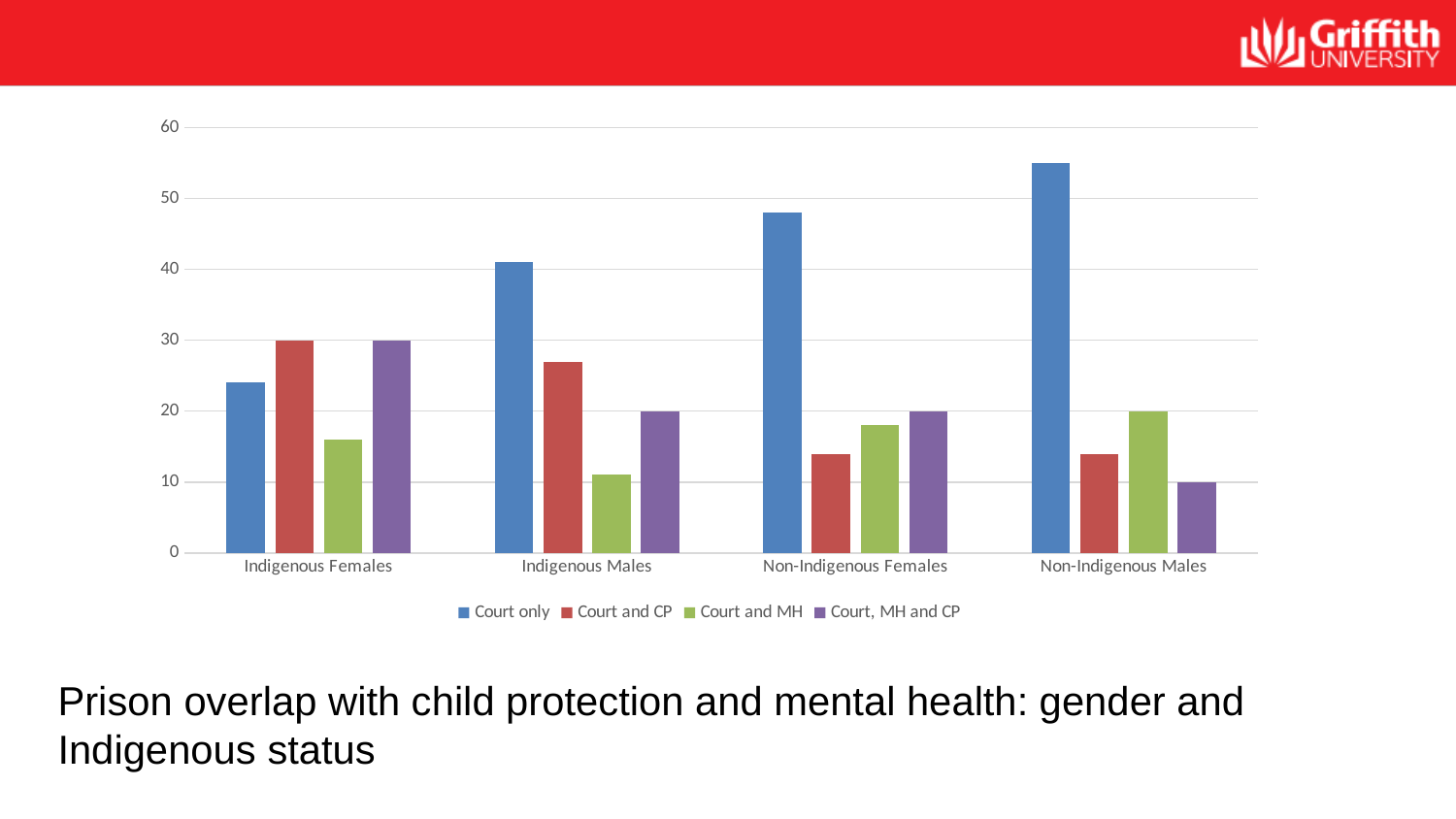
Does the Court only series rise or fall moving from Indigenous Females to Non-Indigenous Males along the x axis? Rises Which is larger: the Court only value for Indigenous Males or for Non-Indigenous Females? Non-Indigenous Females Which category has the highest value for the Court only series? Non-Indigenous Males Which category has the lowest value for the Court, MH and CP series? Non-Indigenous Males What colour represents the Court and MH series in the chart? Green What is the Court, MH and CP value for Non-Indigenous Males? 10 How many series does the chart's legend list? 4 What kind of chart is shown on the slide? Bar chart What is the Court and CP value for Indigenous Females? 30 Is the Court and MH value for Indigenous Males greater or less than 20? less How many categories are shown along the x axis of the chart? 4 Is the Court only value for Non-Indigenous Males greater or less than 50? greater